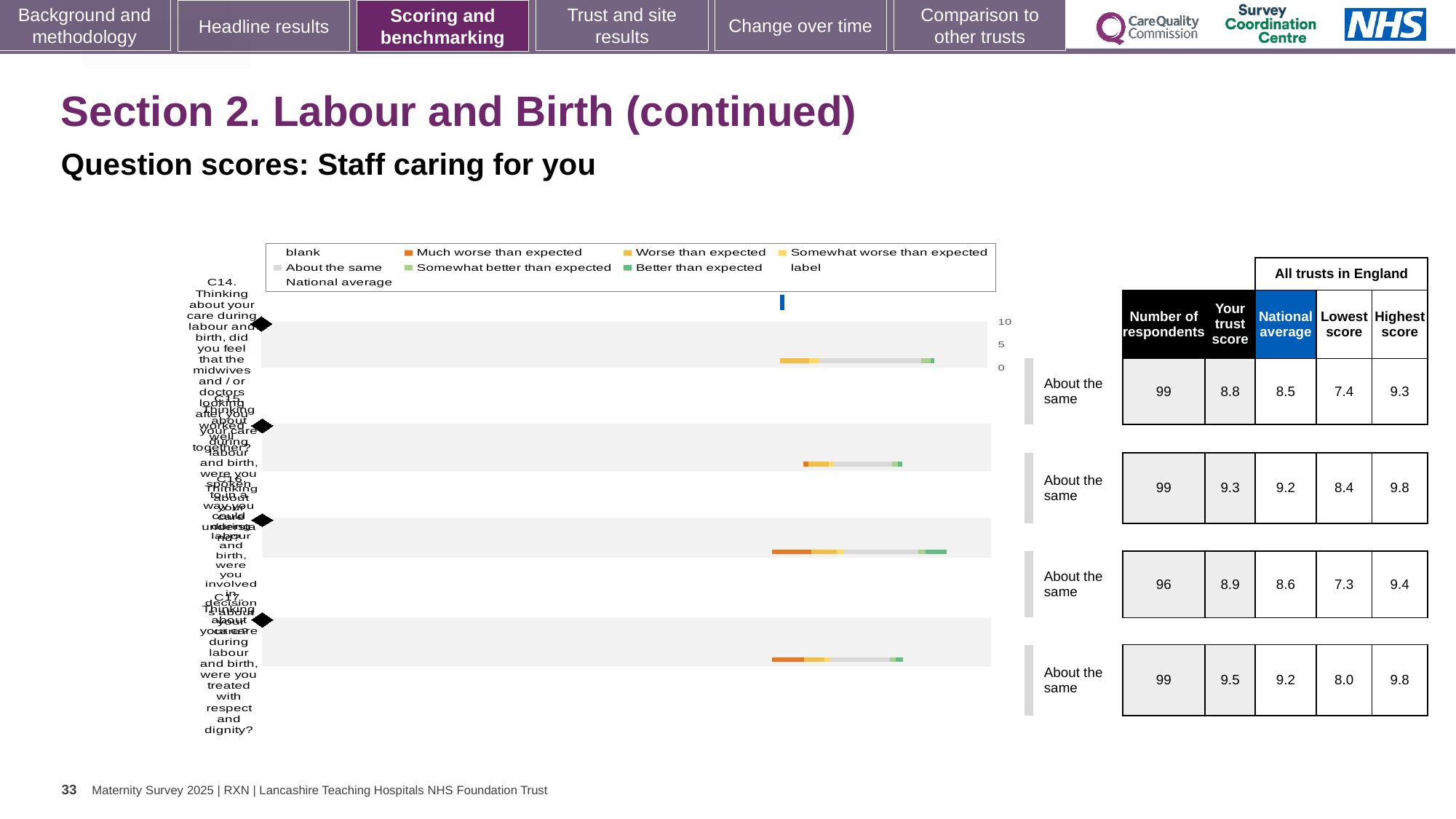
According to the table beside the chart, what is the national average for question C15? 9.2 For question C14, which is larger: the trust score or the national average? the trust score According to the table beside the chart, what is the trust score for question C17? 9.5 Which question has the highest trust score in the table beside the chart? C17 According to the table beside the chart, what is the number of respondents for question C16? 96 According to the table beside the chart, what is the lowest score across all trusts in England for question C16? 7.3 In the chart legend, what colour is used for 'Better than expected'? green How many questions (C14 to C17) are plotted as rows in the chart? 4 What kind of chart is shown on the slide? bar chart What is the difference between the trust score and the national average for question C17? 0.3 Which question has the lowest trust score in the table beside the chart? C14 In the chart legend, what colour is used for 'Much worse than expected'? orange